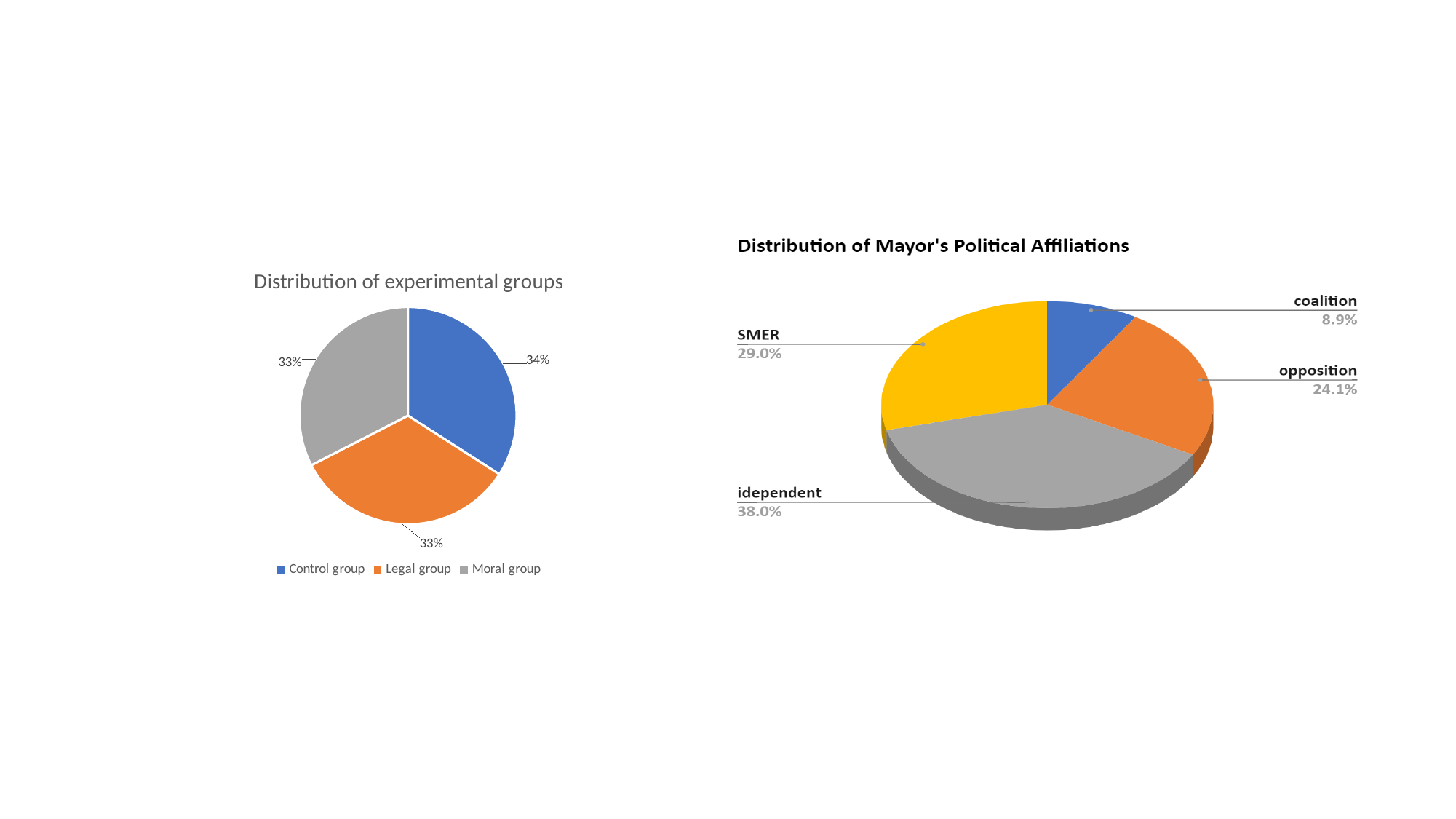
In the 'Distribution of experimental groups' chart, how many groups are shown in the legend? 3 In the 'Distribution of Mayor's Political Affiliations' chart, what is the share for SMER? 29.0% How many categories are shown in the 'Distribution of Mayor's Political Affiliations' chart? 4 In the 'Distribution of experimental groups' chart, which colour represents the Moral group? Grey In the 'Distribution of experimental groups' chart, what share does the Legal group have? 33% In the 'Distribution of Mayor's Political Affiliations' chart, what is the share for coalition? 8.9% In the 'Distribution of Mayor's Political Affiliations' chart, which category has the largest share? idependent In the 'Distribution of Mayor's Political Affiliations' chart, which is larger, SMER or opposition? SMER In the 'Distribution of Mayor's Political Affiliations' chart, which category has the smallest share? coalition In the 'Distribution of experimental groups' chart, what share does the Control group have? 34% In the 'Distribution of Mayor's Political Affiliations' chart, what is the difference between the idependent and opposition shares? 13.9% What kind of chart is 'Distribution of experimental groups'? Pie chart